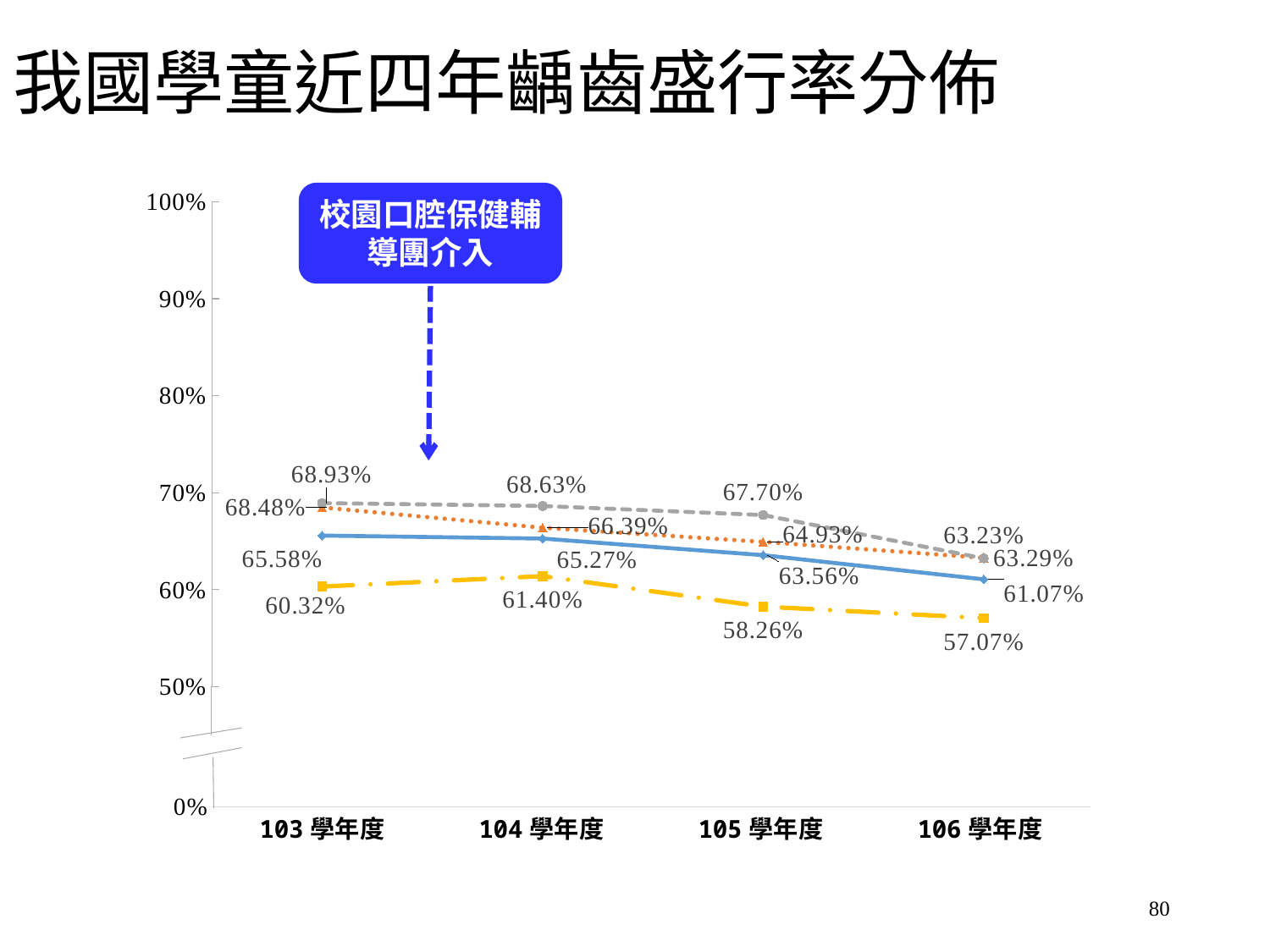
What is the value of the blue solid line at 106 學年度? 61.07% How many school years (categories) are shown on the x axis? 4 Is the value of the yellow dash-dot line at 105 學年度 greater or less than 60%? less What is the value of the grey dashed line at 103 學年度? 68.93% Which line has the lowest value at 106 學年度? the yellow dash-dot line Which line has the highest value at 103 學年度? the grey dashed line By how many percentage points does the yellow dash-dot line drop from 103 學年度 (60.32%) to 106 學年度 (57.07%)? 3.25 percentage points Does the blue solid line rise or fall from 103 學年度 to 106 學年度? fall What is the value of the yellow dash-dot line at 106 學年度? 57.07% What is the value of the yellow dash-dot line at 103 學年度? 60.32% What kind of chart is shown on the slide? line chart What does the blue callout box above the chart say? 校園口腔保健輔導團介入